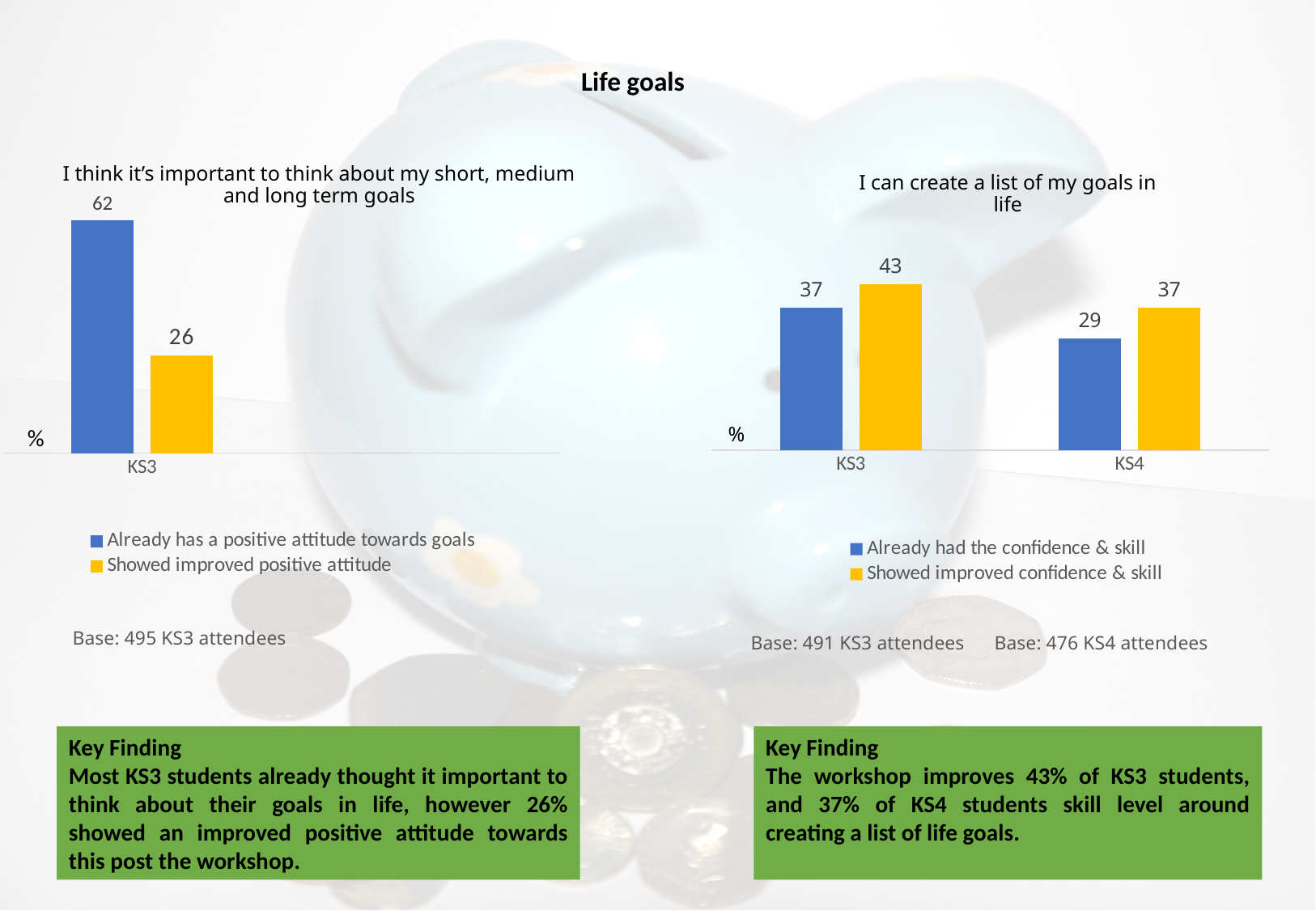
In the chart titled 'I can create a list of my goals in life', which is larger for KS4: 'Already had the confidence & skill' or 'Showed improved confidence & skill'? Showed improved confidence & skill In the chart titled 'I think it's important to think about my short, medium and long term goals', what is the value for 'Showed improved positive attitude' for KS3? 26 In the chart titled 'I can create a list of my goals in life', what is the value for 'Showed improved confidence & skill' for KS4? 37 How many series does the legend list for the chart titled 'I think it's important to think about my short, medium and long term goals'? 2 In the chart titled 'I think it's important to think about my short, medium and long term goals', what is the difference between the two KS3 bars? 36 How many categories are shown on the x axis of the chart titled 'I can create a list of my goals in life'? 2 In the chart titled 'I can create a list of my goals in life', what is the value for 'Already had the confidence & skill' for KS4? 29 In the chart titled 'I can create a list of my goals in life', what is the difference between 'Showed improved confidence & skill' for KS3 and for KS4? 6 In the chart titled 'I can create a list of my goals in life', what is the value for 'Showed improved confidence & skill' for KS3? 43 In the chart titled 'I can create a list of my goals in life', which category has the highest value for 'Showed improved confidence & skill'? KS3 In the chart titled 'I think it's important to think about my short, medium and long term goals', what is the value for 'Already has a positive attitude towards goals' for KS3? 62 What type of chart is the chart titled 'I can create a list of my goals in life'? Bar chart